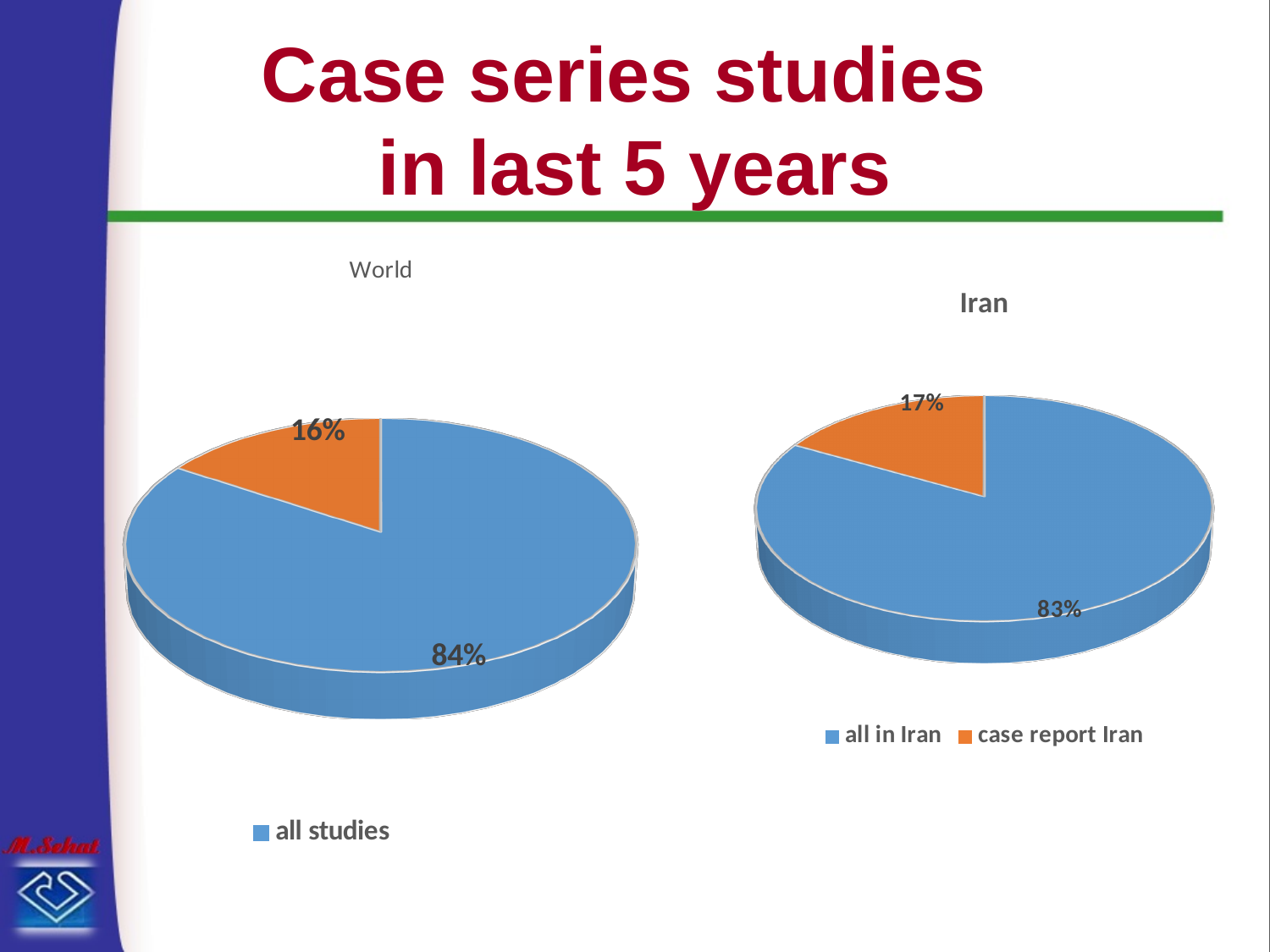
In the "Iran" chart, what share does "case report Iran" have? 17% In the "World" chart, what share does the "all studies" slice have? 84% What kind of chart is the "World" chart? pie chart How many slices does the "Iran" chart have? 2 How many entries does the legend of the "Iran" chart list? 2 Which is larger: the "case report Iran" slice in the "Iran" chart or the orange slice in the "World" chart? case report Iran In the "Iran" chart, which slice is the largest? all in Iran In the "World" chart, what percentage is shown on the orange slice? 16% In the "Iran" chart, what is the difference between the "all in Iran" and "case report Iran" shares? 66% In the "Iran" chart, what share does "all in Iran" have? 83% In the "World" chart, what is the difference between the 84% slice and the 16% slice? 68% In the "Iran" chart, which slice is the smallest? case report Iran